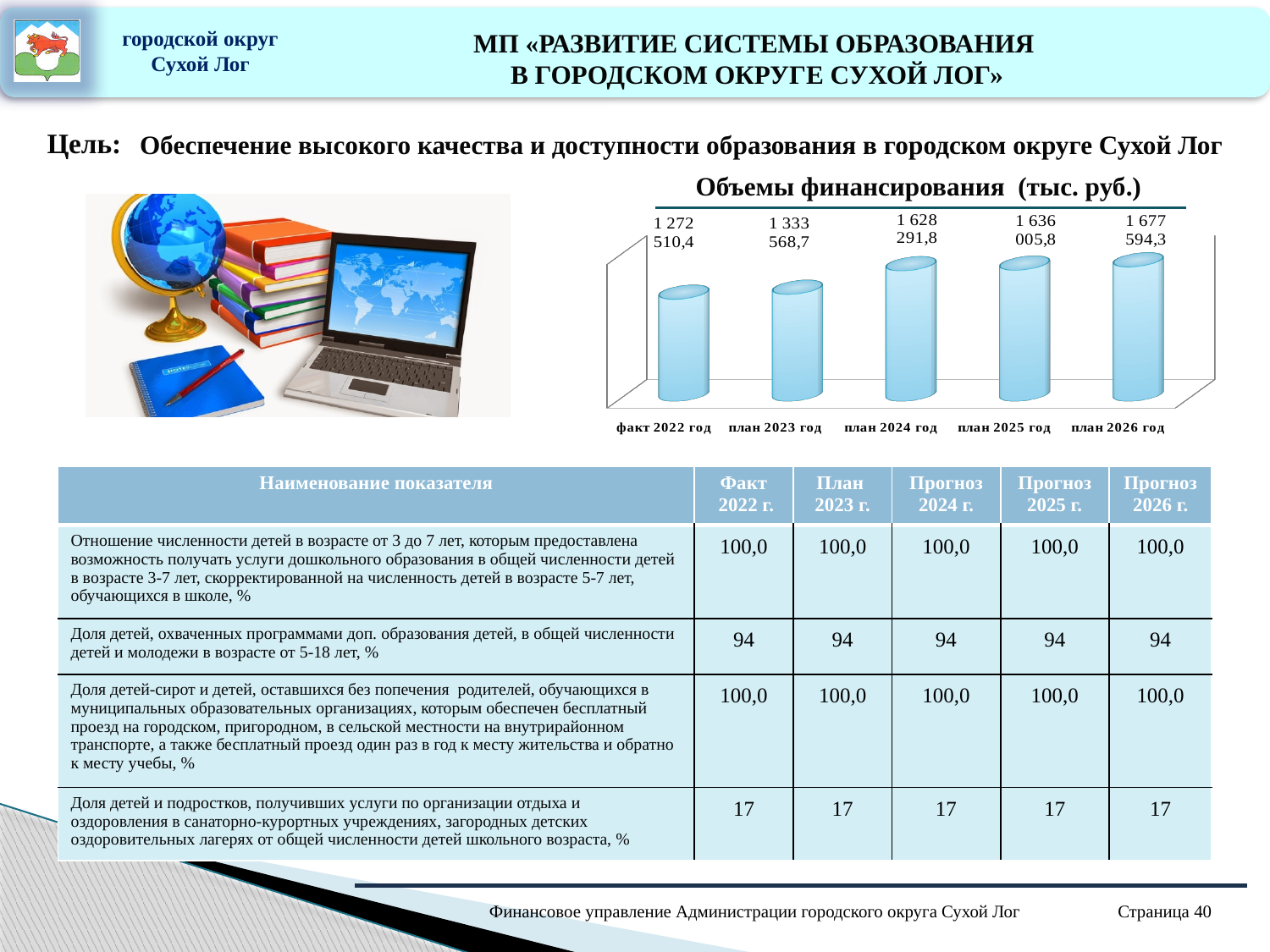
In the chart «Объемы финансирования (тыс. руб.)», what is the difference between план 2026 год and факт 2022 год? 405 083,9 What is the value for факт 2022 год in the chart «Объемы финансирования (тыс. руб.)»? 1 272 510,4 Do the values in the chart «Объемы финансирования (тыс. руб.)» rise or fall from факт 2022 год to план 2026 год? rise In the chart «Объемы финансирования (тыс. руб.)», which is larger: план 2023 год or план 2024 год? план 2024 год What is the value for план 2026 год in the chart «Объемы финансирования (тыс. руб.)»? 1 677 594,3 In the chart «Объемы финансирования (тыс. руб.)», what is the difference between план 2024 год and план 2023 год? 294 723,1 What is the value for план 2023 год in the chart «Объемы финансирования (тыс. руб.)»? 1 333 568,7 Which category has the lowest value in the chart «Объемы финансирования (тыс. руб.)»? факт 2022 год What kind of chart is «Объемы финансирования (тыс. руб.)»? bar chart How many categories are shown in the chart «Объемы финансирования (тыс. руб.)»? 5 Which category has the highest value in the chart «Объемы финансирования (тыс. руб.)»? план 2026 год What is the value for план 2024 год in the chart «Объемы финансирования (тыс. руб.)»? 1 628 291,8